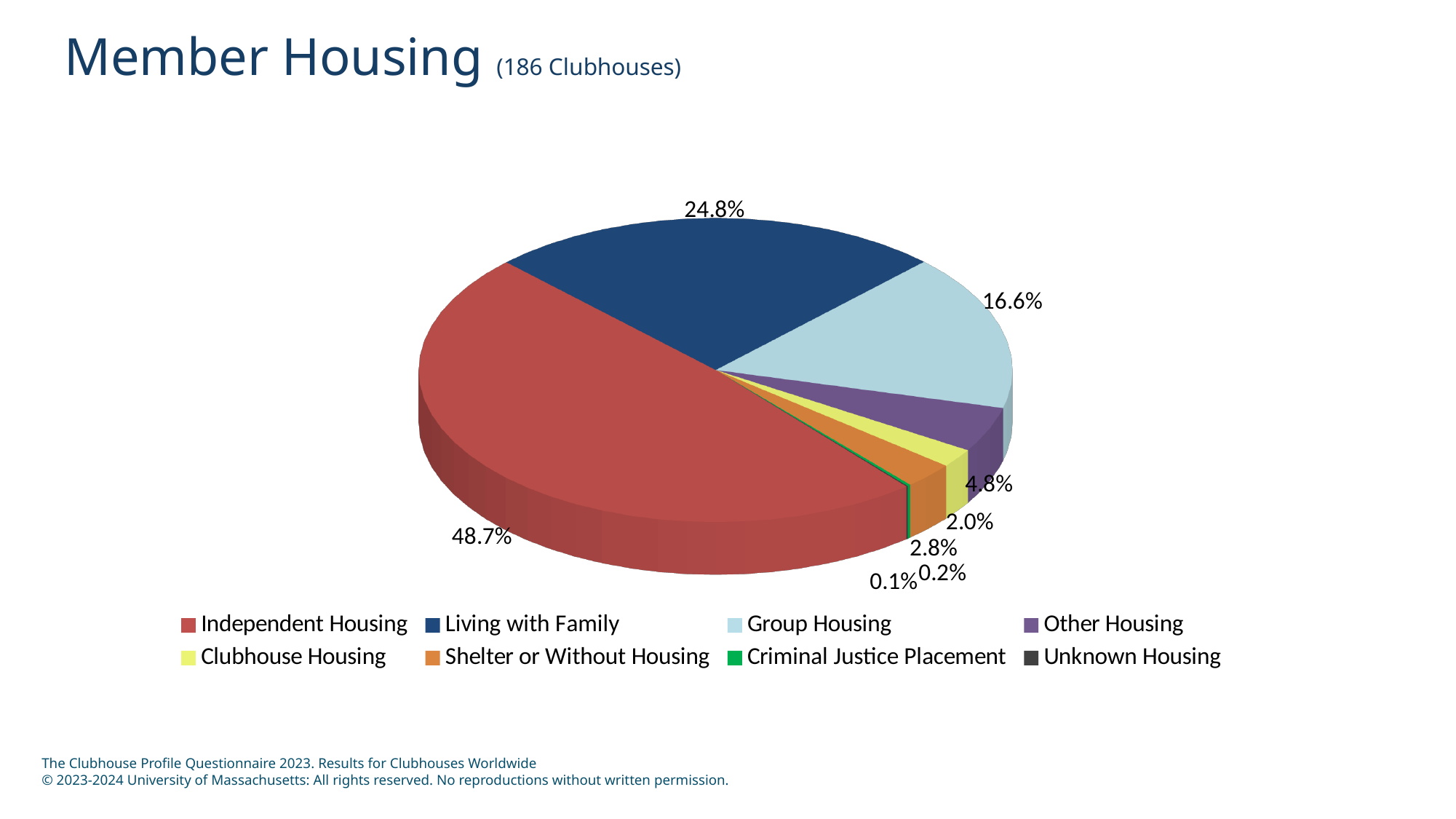
What is the difference between the Independent Housing share and the Living with Family share? 23.9% Which housing category has the largest slice of the pie? Independent Housing Which is larger, the Group Housing share or the Other Housing share? Group Housing What kind of chart is shown on the slide? pie chart What share of the pie is Living with Family? 24.8% What share of the pie is Group Housing? 16.6% What share of the pie is Clubhouse Housing? 2.0% How many housing categories does the legend list? 8 What share of the pie is Shelter or Without Housing? 2.8% What is the title of the chart slide? Member Housing (186 Clubhouses) What share of the pie is Other Housing? 4.8% What share of the pie is Independent Housing? 48.7%